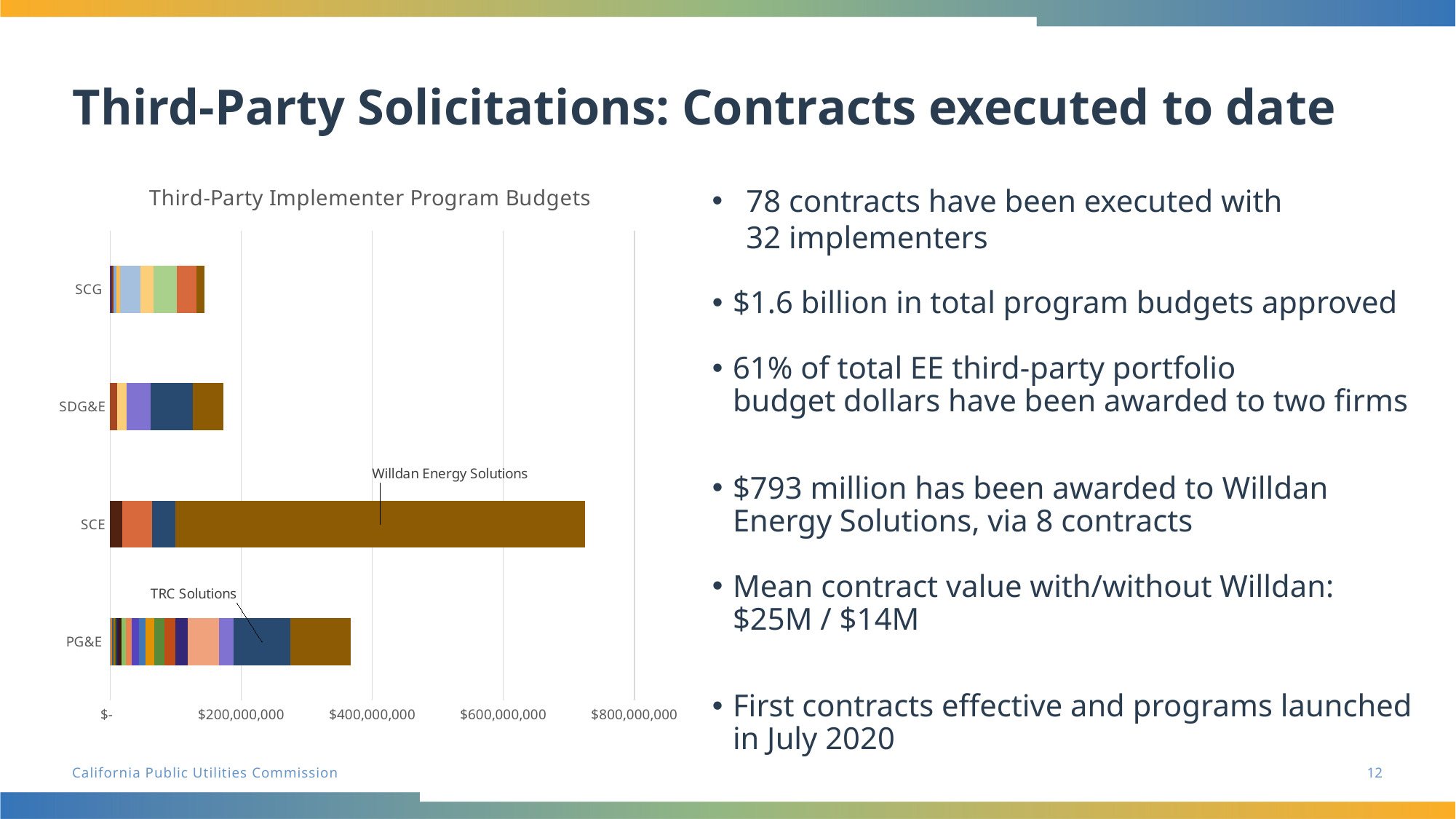
Is the total bar for PG&E greater or less than $400,000,000? less Which has a larger total program budget, SDG&E or SCG? SDG&E Which utility has the smallest total third-party implementer program budget? SCG Which utility has the largest total third-party implementer program budget? SCE Is the total bar for SCG greater or less than $200,000,000? less Is the total bar for SCE greater or less than $600,000,000? greater What is the title of the chart? Third-Party Implementer Program Budgets Which has a larger total program budget, SCE or PG&E? SCE What kind of chart is shown on the slide? Stacked bar chart How many utilities (categories) are shown on the chart? 4 Which implementer is labelled on the largest segment of the SCE bar? Willdan Energy Solutions